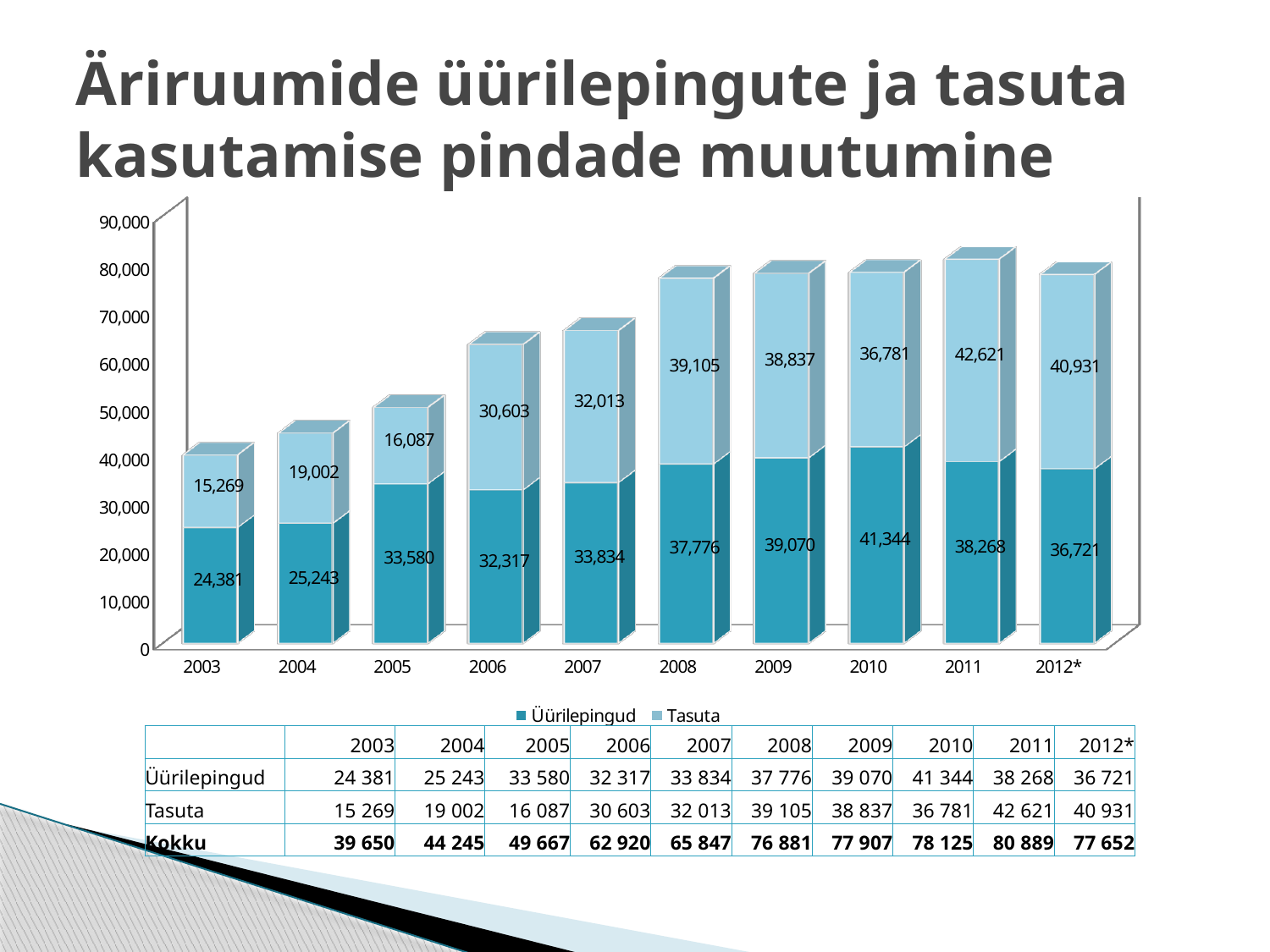
What is the difference between Üürilepingud and Tasuta in 2010? 4,563 What is the value of Üürilepingud for 2003? 24,381 What is the value of Tasuta for 2012*? 40,931 How many series does the legend list? 2 What is the total of the stacked bar for 2011? 80 889 What kind of chart is shown on the slide? stacked bar chart In which year is the Üürilepingud value highest? 2010 In which year is the Tasuta value lowest? 2003 What is the value of Tasuta for 2011? 42,621 Is the total height of the 2006 stacked bar greater or less than 60,000? greater In 2008, which is larger: Üürilepingud or Tasuta? Tasuta How many years are shown on the x axis? 10